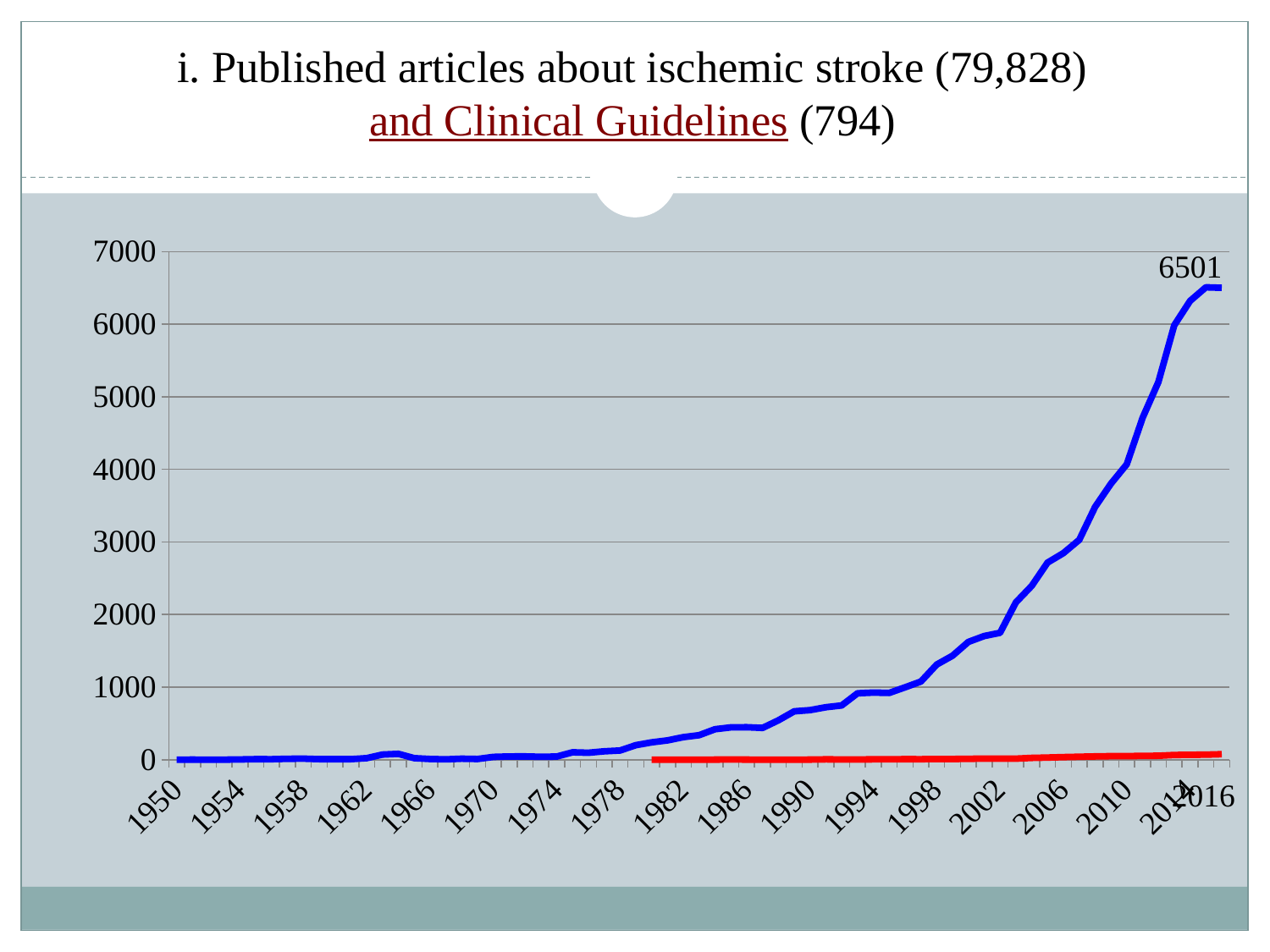
Is the value of the blue line in 1970 greater or less than 1000? less What kind of chart is shown on the slide? line chart In 2016, which line has the larger value, the blue line or the red line? the blue line Is the value of the red line in 2016 greater or less than 1000? less According to the slide title, how many published Clinical Guidelines are there? 794 Is the value of the blue line in 1990 greater or less than 1000? less How many lines (series) are plotted on the chart? 2 What is the highest value shown on the y axis? 7000 Does the blue line generally rise or fall from 1950 to 2016? rise What is the value printed as a data label at the end of the blue line? 6501